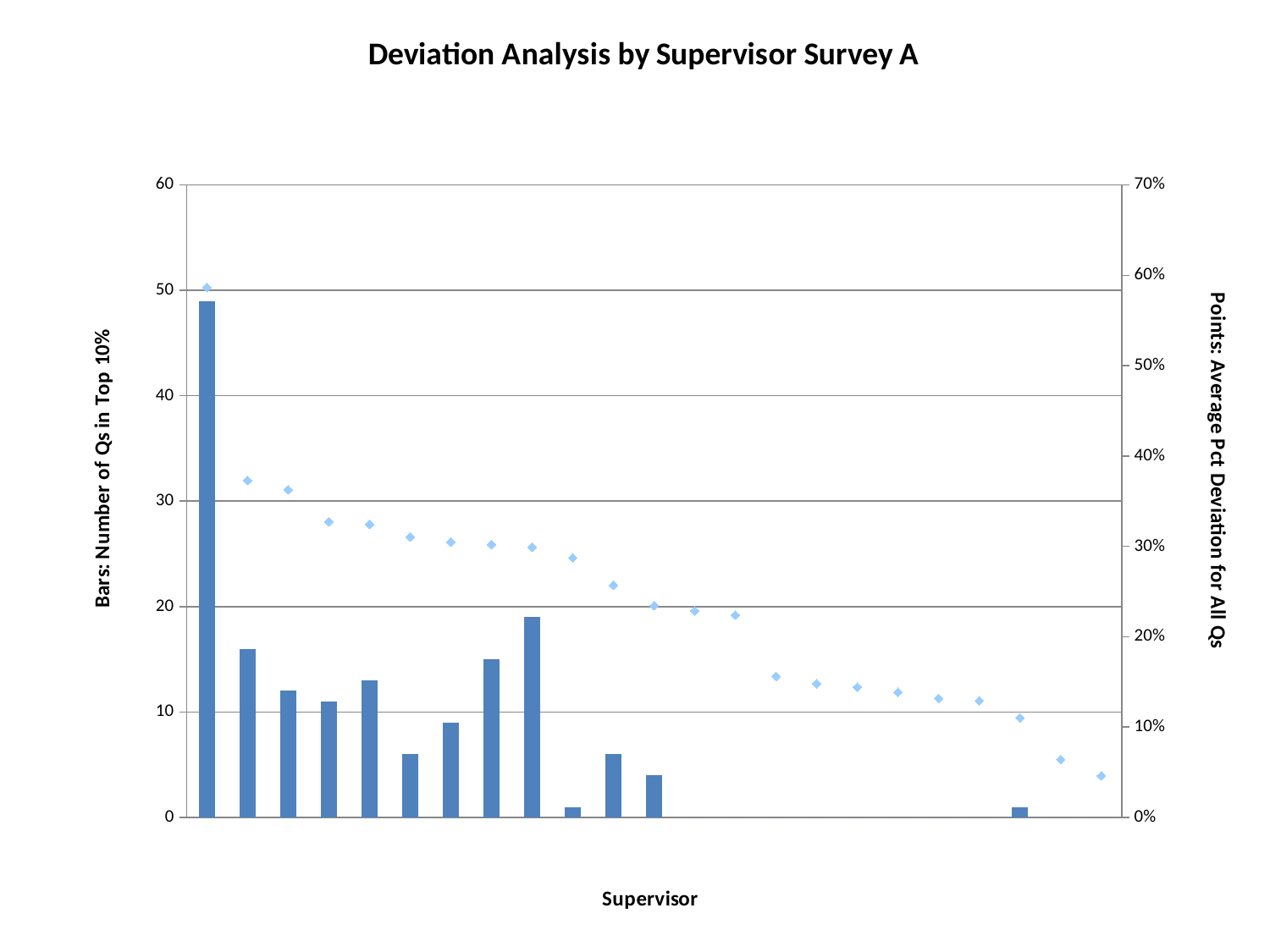
What is the title of the chart? Deviation Analysis by Supervisor Survey A What is the label of the left vertical axis? Bars: Number of Qs in Top 10% Is the value of the rightmost point greater or less than 10%? less Which bar is the tallest: the leftmost bar or the second bar from the left? The leftmost bar How many bars are plotted on the chart? 13 What is the highest tick value shown on the left vertical axis? 60 What kind of chart is this? Bar chart with points (combination chart) Is the value of the second bar from the left greater or less than 20? less Is the value of the tallest bar greater or less than 40? greater Do the point values rise or fall from left to right along the x axis? Fall